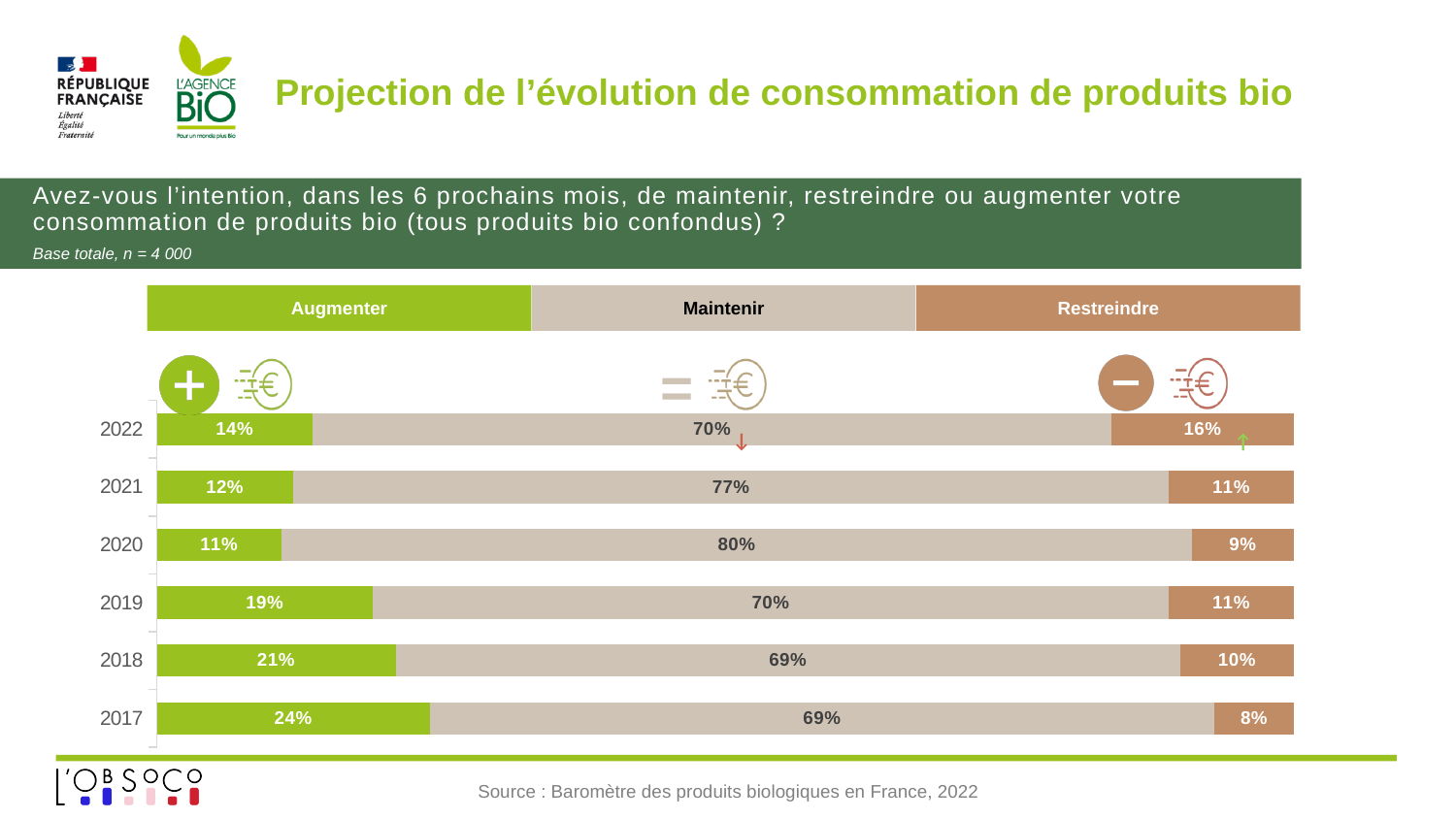
What is the value for Restreindre in 2017? 8% Which year has the lowest value for Restreindre? 2017 Which year has the highest value for Augmenter? 2017 What is the total of the stacked bar for 2018? 100% What is the value for Augmenter in 2022? 14% Which is larger, the Augmenter value for 2019 or for 2020? 2019 Which colour represents the Restreindre series in the legend? Brown What kind of chart is shown on the slide? Stacked bar chart What is the difference between the Maintenir values for 2021 and 2022? 7 percentage points How many series does the legend list? 3 What is the value for Maintenir in 2020? 80% How many years are shown in the chart? 6